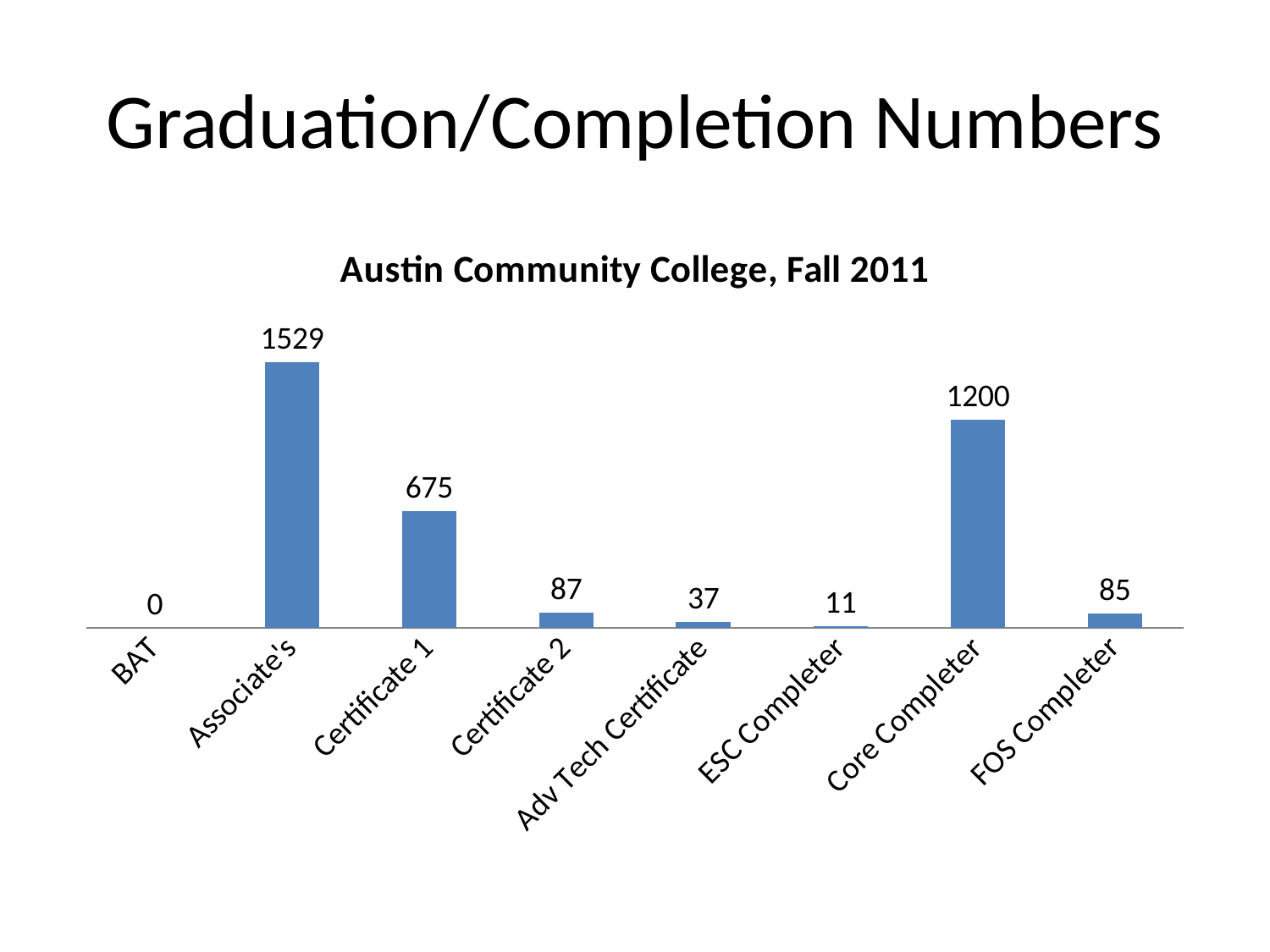
What is the value for Associate's? 1529 Which category has the lowest value? BAT How many categories are shown on the x axis? 8 What is the difference between the values for Certificate 2 and FOS Completer? 2 What is the value for Certificate 1? 675 What kind of chart is this? Bar chart Which category has the highest value? Associate's What is the value for Core Completer? 1200 What is the title of the chart? Austin Community College, Fall 2011 What is the difference between the values for Associate's and Core Completer? 329 What is the value for ESC Completer? 11 Which is larger, the value for Certificate 1 or the value for Core Completer? Core Completer